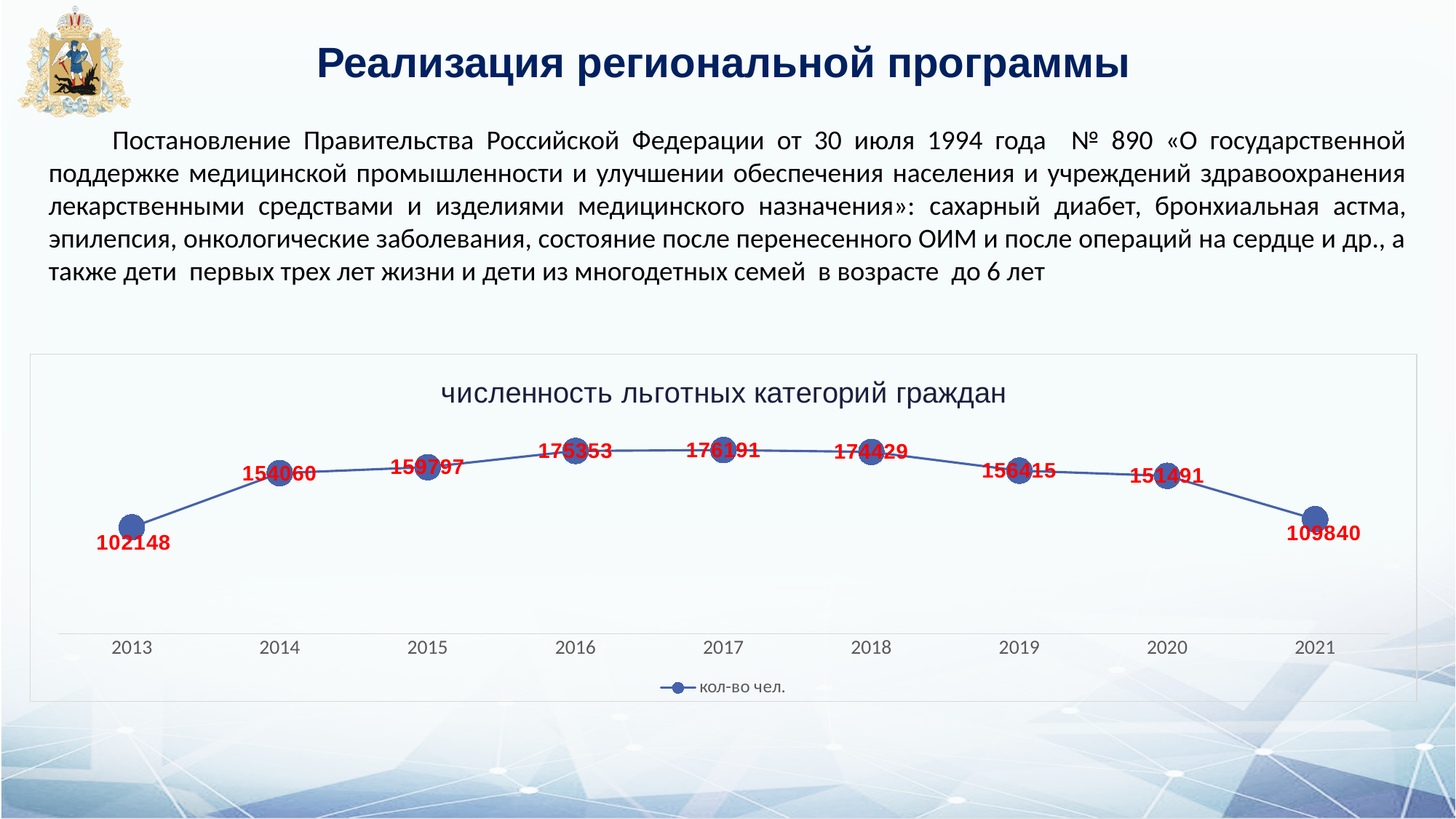
What is the difference between the values for 2014 and 2013? 51912 What is the value for 2017? 176191 How many years are plotted on the chart? 9 What is the value for 2021? 109840 What is the difference between the values for 2020 and 2021? 41651 What is the title of the chart? численность льготных категорий граждан Which year has the highest value? 2017 How many series does the legend list? 1 What is the value for 2013? 102148 What kind of chart is shown? line chart Which is larger, the value for 2016 or the value for 2019? 2016 Which year has the lowest value? 2013